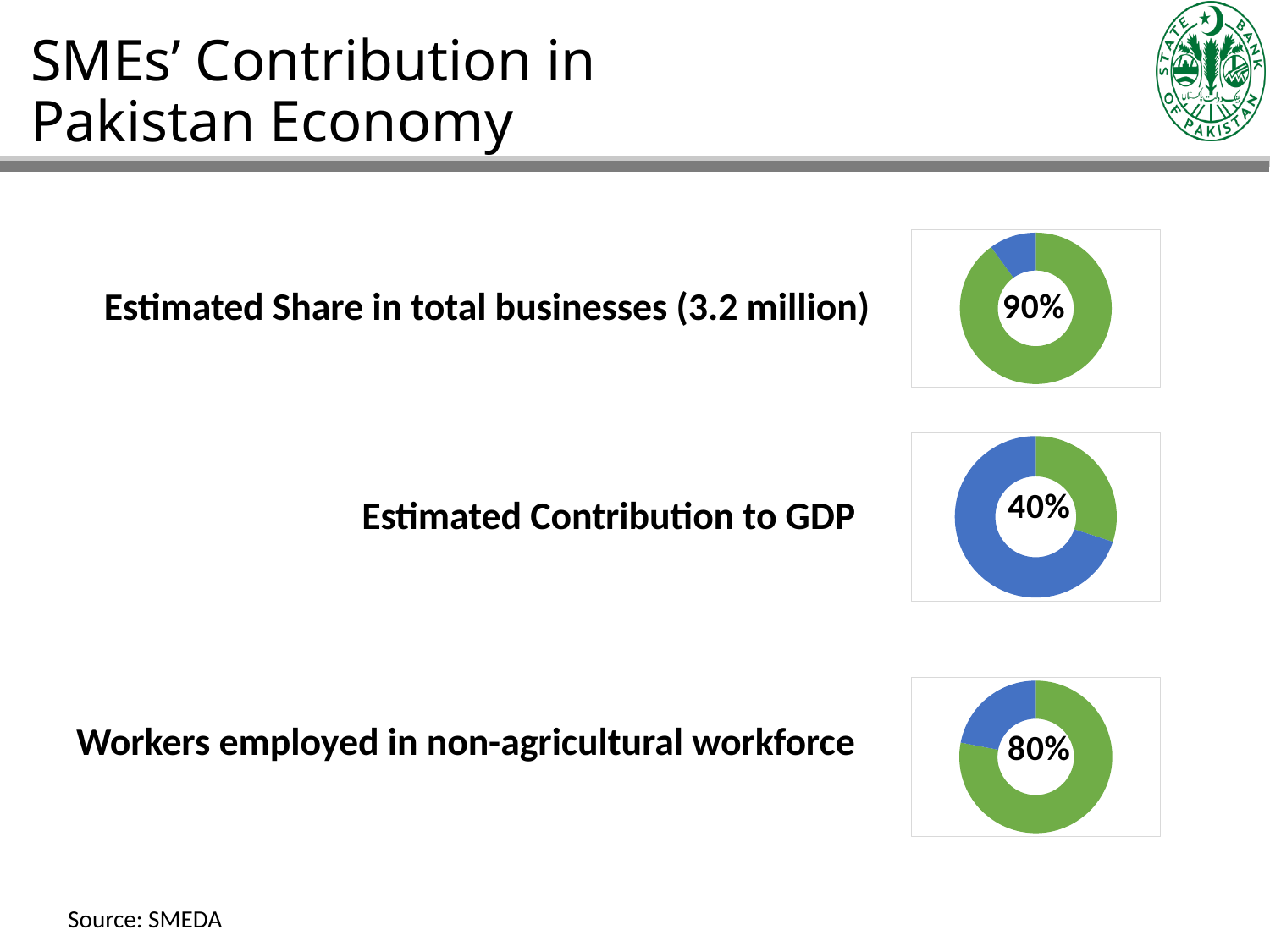
In the 'Estimated Contribution to GDP' doughnut chart, which colour occupies the larger portion of the ring? Blue What kind of chart is used for each of the three figures on the slide? Doughnut (pie) chart Of the three doughnut charts, which one shows the lowest printed value? Estimated Contribution to GDP What is the difference between the value for 'Estimated Share in total businesses' (90%) and the value for 'Estimated Contribution to GDP' (40%)? 50% How many doughnut charts are shown on the slide? 3 In the chart next to 'Workers employed in non-agricultural workforce', what value is printed in the centre of the doughnut? 80% In the chart next to 'Estimated Share in total businesses (3.2 million)', what value is printed in the centre of the doughnut? 90% Which is larger: the value shown for 'Estimated Share in total businesses' or the value shown for 'Estimated Contribution to GDP'? Estimated Share in total businesses What is the difference between the value for 'Estimated Share in total businesses' (90%) and the value for 'Workers employed in non-agricultural workforce' (80%)? 10% In the chart next to 'Estimated Contribution to GDP', what value is printed in the centre of the doughnut? 40% What source is cited at the bottom of the slide for the charts? SMEDA Of the three doughnut charts, which one shows the highest printed value? Estimated Share in total businesses (3.2 million)